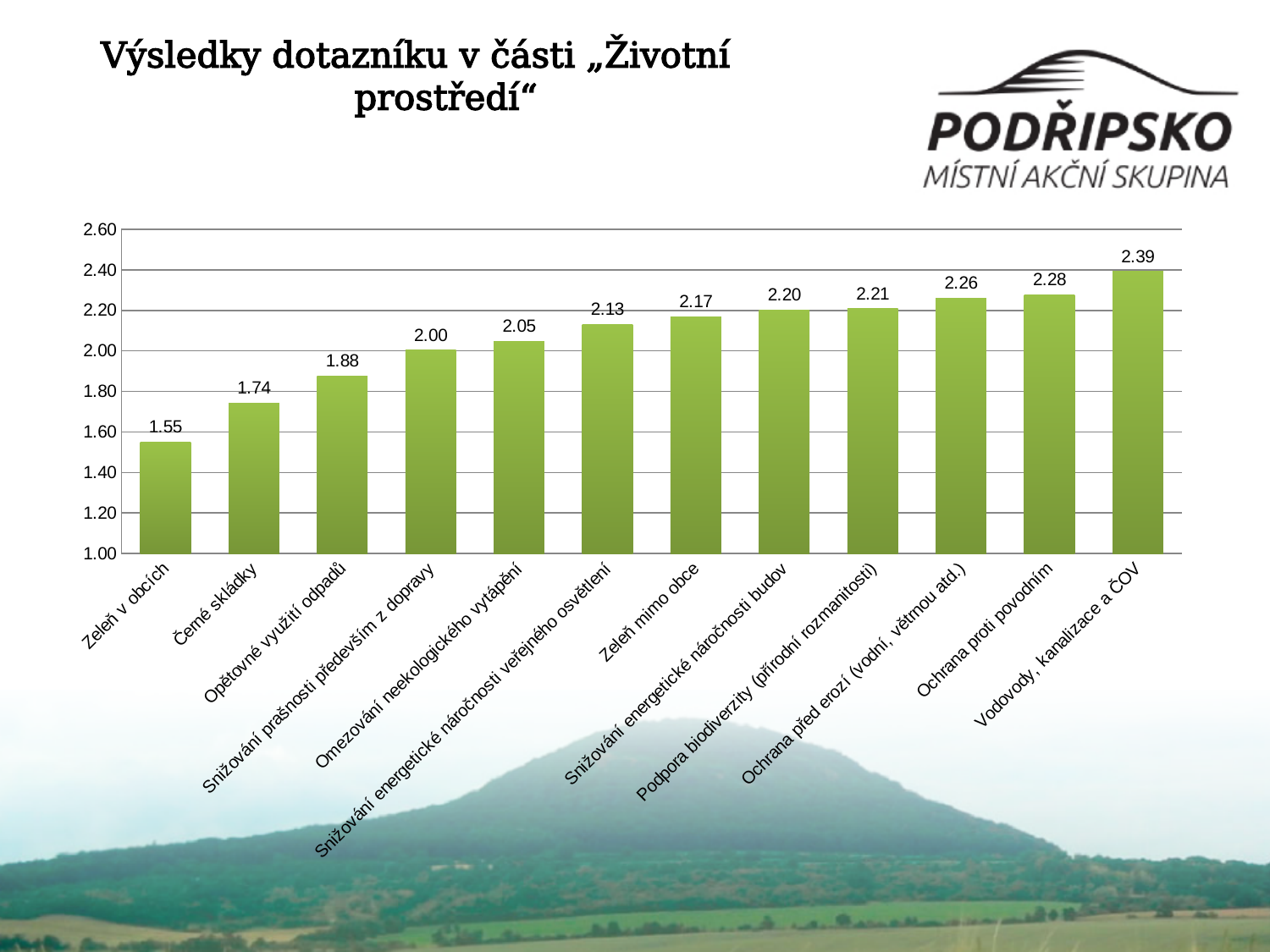
How many categories are shown in the chart? 12 What is the difference between the values for "Vodovody, kanalizace a ČOV" and "Zeleň v obcích"? 0.84 Which category has the highest value? Vodovody, kanalizace a ČOV Is the value for "Ochrana před erozí (vodní, větrnou atd.)" greater or less than 2.00? greater What is the value for "Zeleň v obcích"? 1.55 Which is larger, the value for "Zeleň mimo obce" or the value for "Snižování prašnosti především z dopravy"? Zeleň mimo obce What kind of chart is shown on the slide? bar chart Which category has the lowest value? Zeleň v obcích What is the value for "Omezování neekologického vytápění"? 2.05 Do the values rise or fall from left to right along the x axis? rise What is the difference between the values for "Opětovné využití odpadů" and "Černé skládky"? 0.14 What is the value for "Ochrana proti povodním"? 2.28